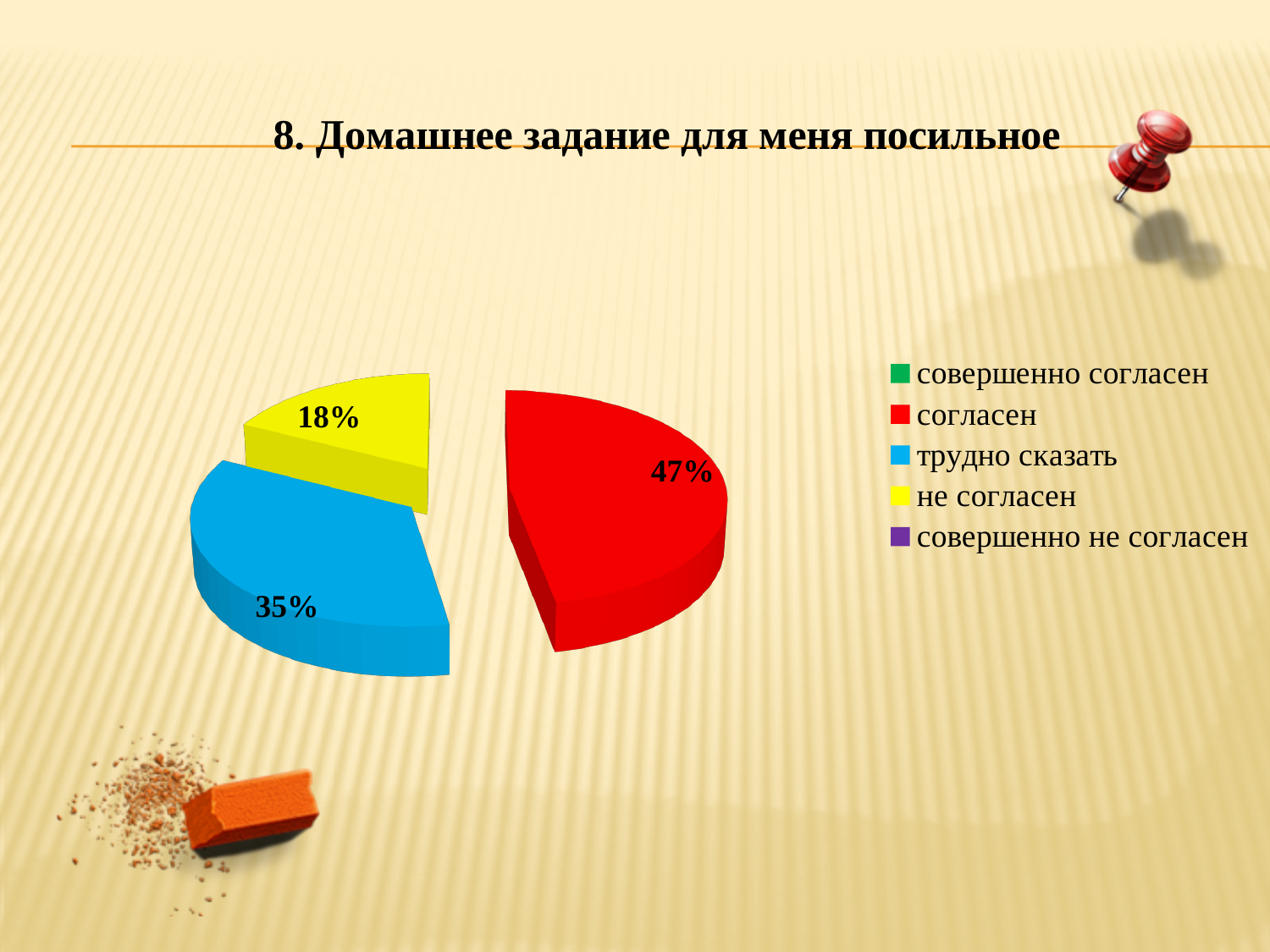
Which is larger, the value for "трудно сказать" or the value for "не согласен"? трудно сказать Which category has the largest slice of the pie? согласен What kind of chart is shown on the slide? pie chart What colour is the slice for "трудно сказать"? blue What is the value for "не согласен"? 18% Which of the labelled slices is the smallest? не согласен What is the value for "трудно сказать"? 35% What is the difference between the values for "трудно сказать" and "не согласен"? 17% What is the difference between the values for "согласен" and "трудно сказать"? 12% What is the value for "согласен"? 47% How many entries does the legend list? 5 How many slices with data labels are visible in the pie? 3